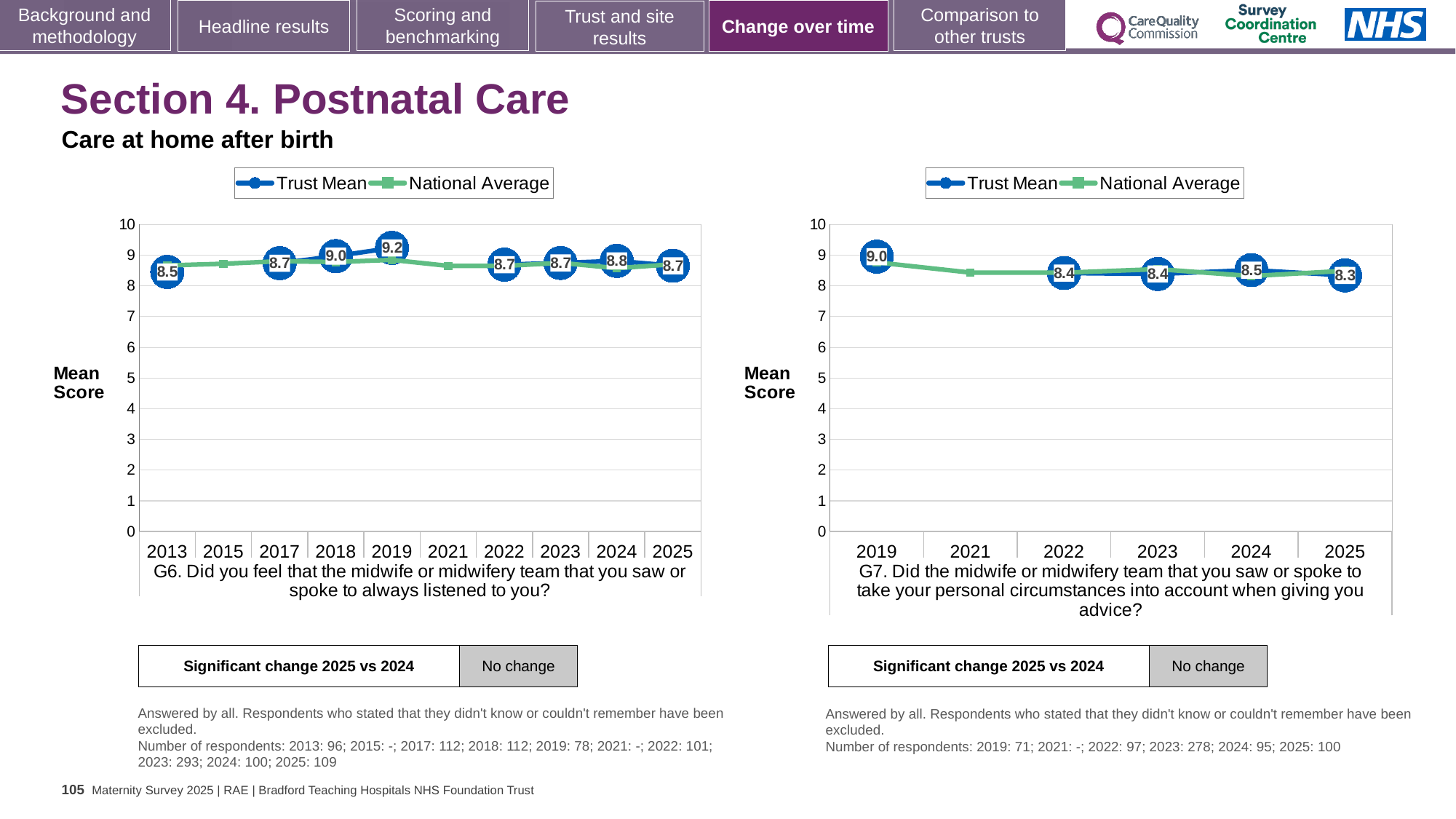
In the G7 chart on the right, is the Trust Mean value for 2022 greater or less than 5? greater In the G6 chart on the left, what is the difference between the Trust Mean scores for 2019 and 2025? 0.5 In the G7 chart on the right, is the Trust Mean score for 2019 larger than the score for 2024? Yes In the G7 chart on the right, what is the Trust Mean score for 2025? 8.3 In the G6 chart on the left, which year has the highest Trust Mean score? 2019 In the G6 chart on the left, what is the Trust Mean score for 2013? 8.5 In the G6 chart on the left, how many years are shown on the x axis? 10 What type of chart is the G6 chart on the left? Line chart In the G6 chart on the left, what is the Trust Mean score for 2019? 9.2 In the G6 chart on the left, which year has the lowest labelled Trust Mean score? 2013 How many series does the legend of the G7 chart on the right list? 2 In the G7 chart on the right, which year has the highest Trust Mean score? 2019